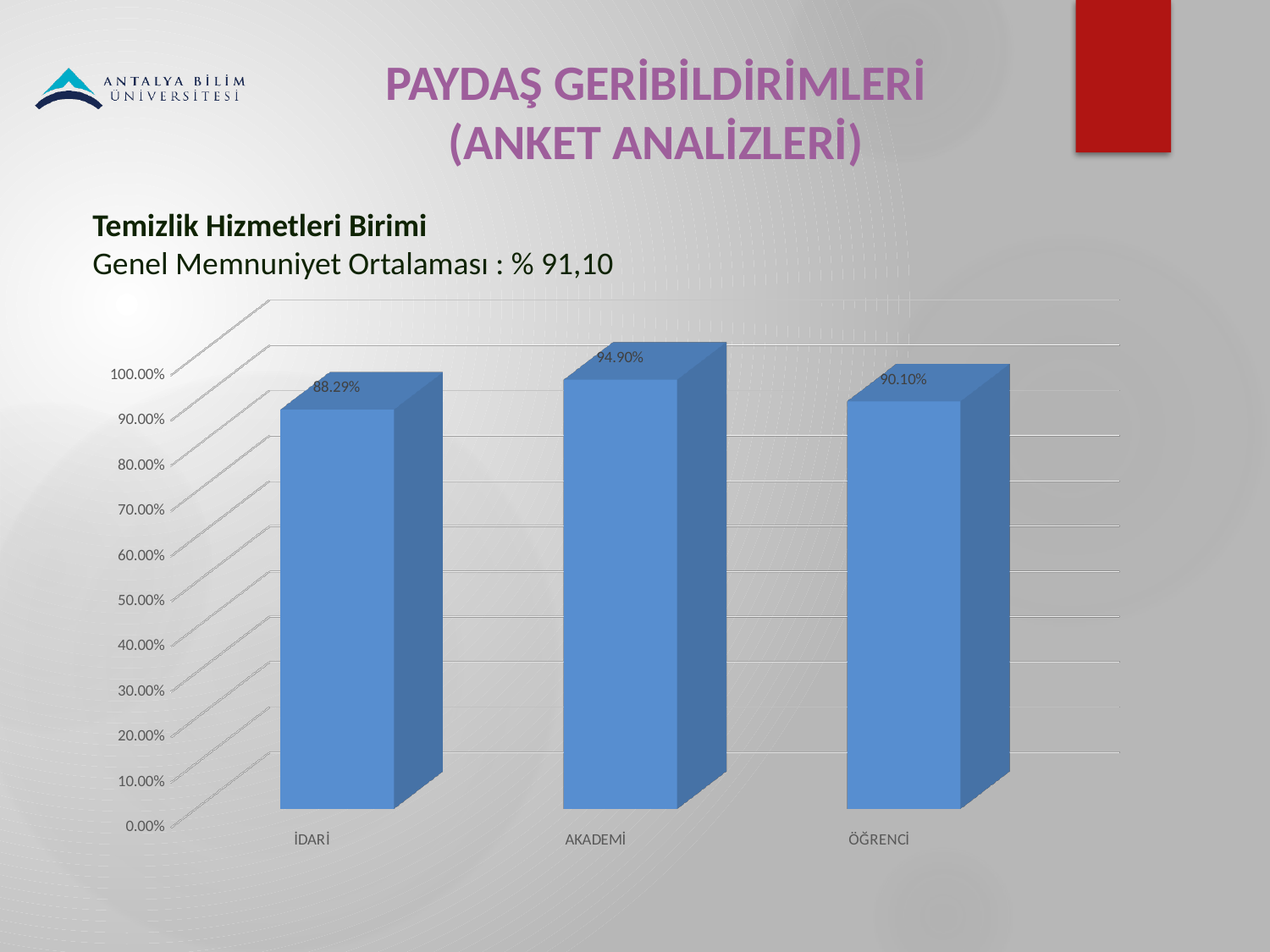
What is the difference between the values for AKADEMİ and İDARİ? 6.61% Which category has the highest value? AKADEMİ What is the value for ÖĞRENCİ? 90.10% What is the value for AKADEMİ? 94.90% What is the overall satisfaction average (Genel Memnuniyet Ortalaması) stated above the chart? % 91,10 Which category has the lowest value? İDARİ What is the difference between the values for ÖĞRENCİ and İDARİ? 1.81% What kind of chart is shown on the slide? bar chart Which is larger, the value for ÖĞRENCİ or the value for İDARİ? ÖĞRENCİ What is the value for İDARİ? 88.29% Is the value for İDARİ greater or less than 90.00%? less How many categories are shown on the chart? 3